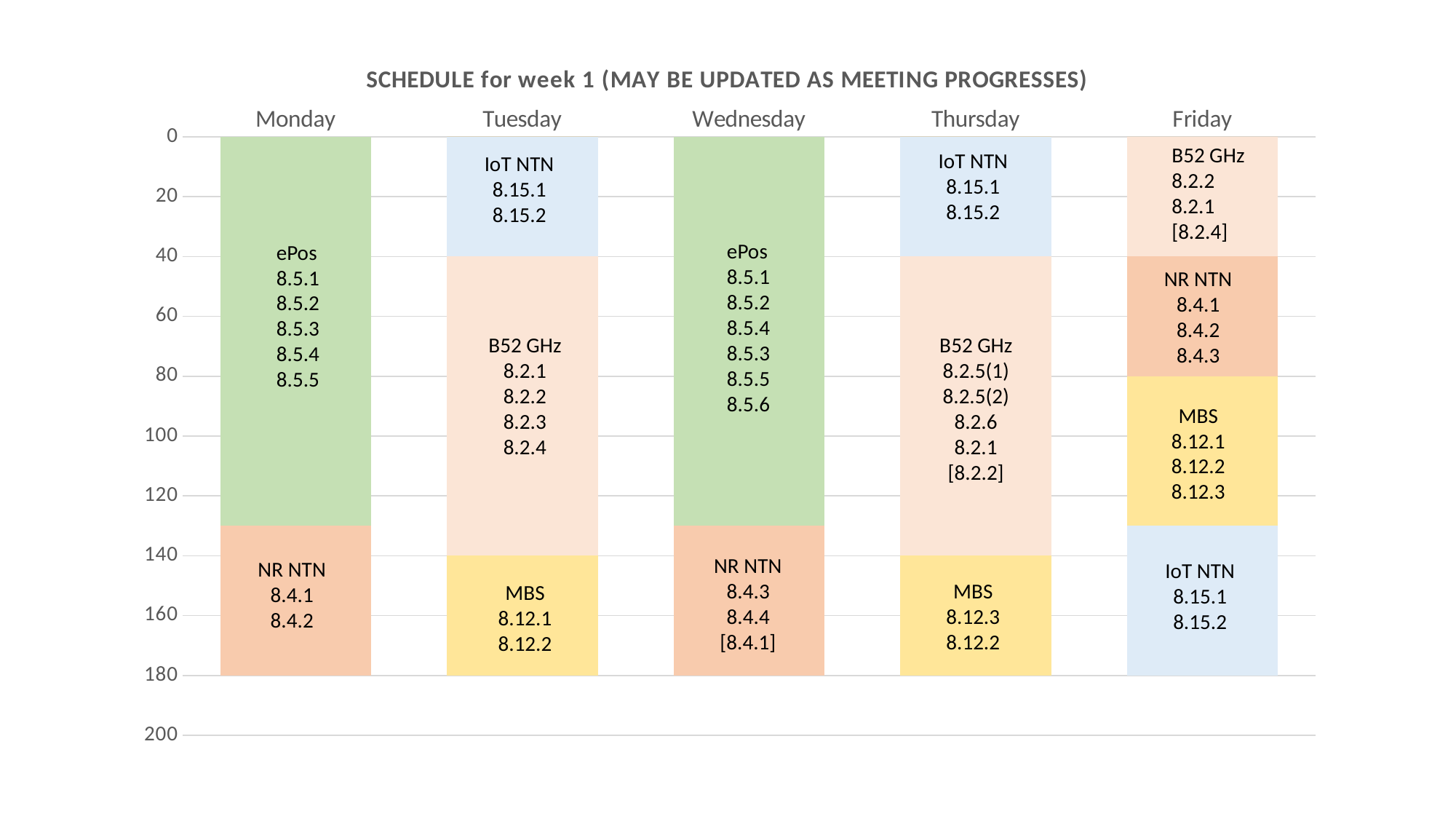
How many axis units does the B52 GHz segment on Tuesday span? 100 Which is larger on Tuesday: the B52 GHz segment or the MBS segment? B52 GHz What kind of chart is shown on the slide? bar chart How many segments make up the Friday bar? 4 What is the title of the chart? SCHEDULE for week 1 (MAY BE UPDATED AS MEETING PROGRESSES) How many axis units does the NR NTN segment on Friday span? 40 Is the NR NTN segment on Wednesday greater or less than 60 axis units? less How many axis units does the IoT NTN segment on Tuesday span? 40 How many days (categories) are shown along the x axis? 5 How many axis units does the MBS segment on Thursday span? 40 Is the ePos segment on Monday longer or shorter than 120 axis units? longer At what axis value does the bottom of each day's stacked bar end? 180